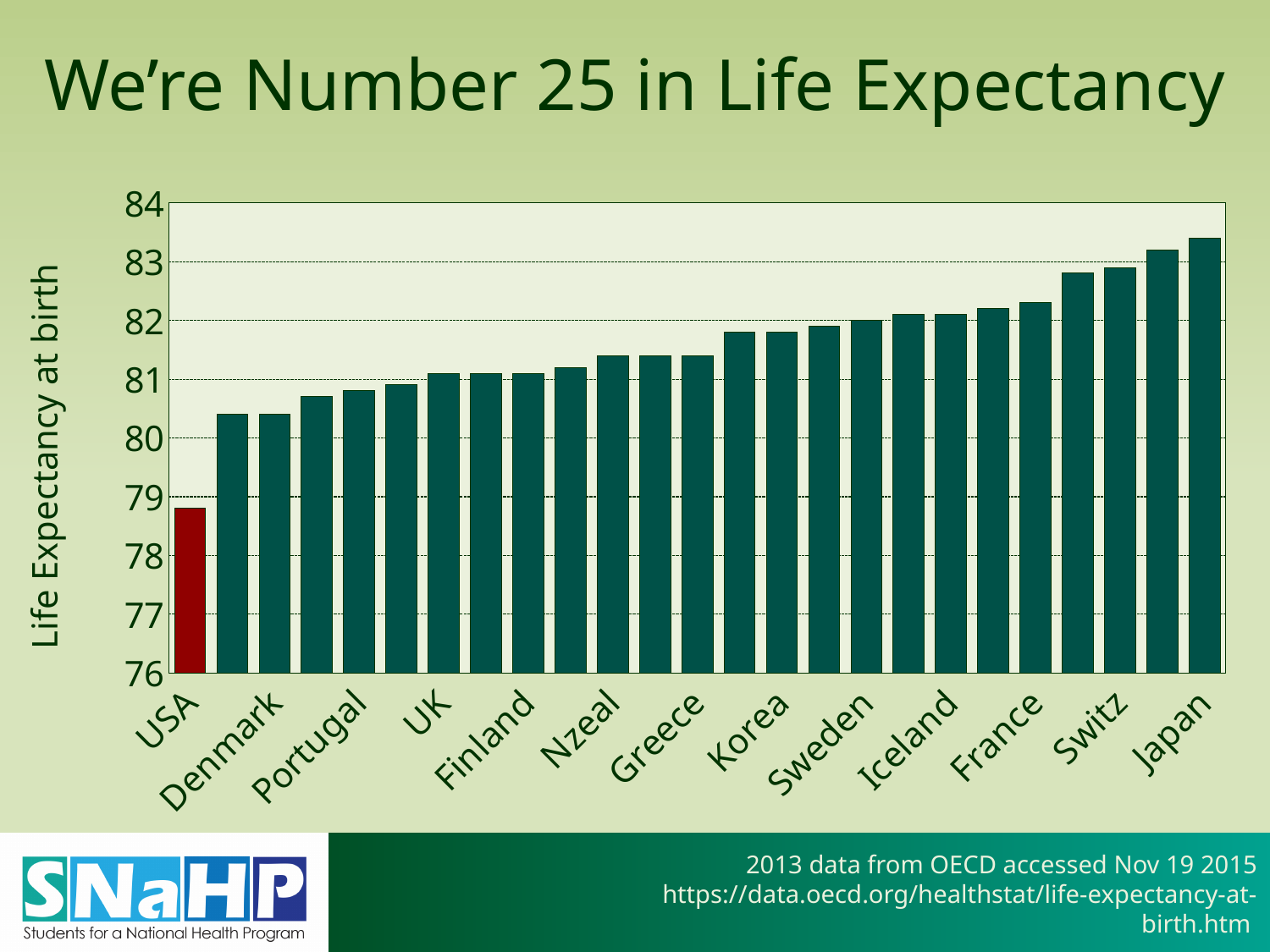
Is the value for France greater or less than 82? greater Which country has the highest life expectancy at birth in the chart? Japan Is the value for Denmark greater or less than 80? greater Is the value for Japan greater or less than 83? greater What colour is the bar for USA? red What kind of chart is shown on the slide? bar chart Do the values rise or fall moving from left to right along the x axis? rise Which country has the lowest life expectancy at birth in the chart? USA Which has the higher life expectancy, Greece or Switz? Switz